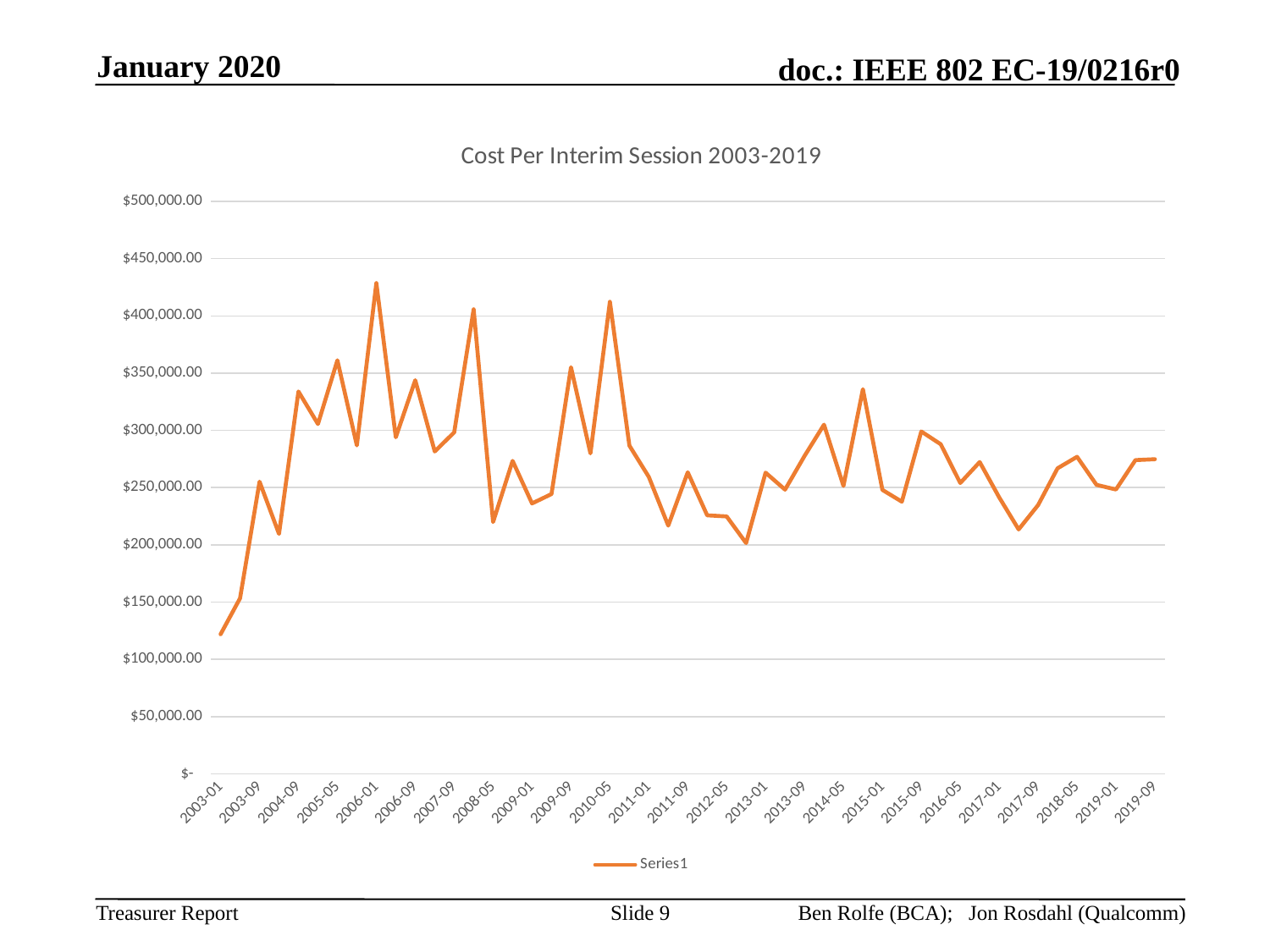
How many series does the legend list? 1 Is the value for 2003-01 greater or less than $150,000.00? less What is the name of the series shown in the legend? Series1 Is the value for 2017-09 greater or less than $250,000.00? less Which labelled session has the highest cost on the chart? 2006-01 What kind of chart is shown on the slide? line chart What is the title of the chart? Cost Per Interim Session 2003-2019 Is the value for 2006-01 greater or less than $400,000.00? greater Which labelled session has the lowest cost on the chart? 2003-01 Do the values rise or fall from 2003-01 to 2004-09? rise Which is larger, the value for 2003-01 or the value for 2019-09? 2019-09